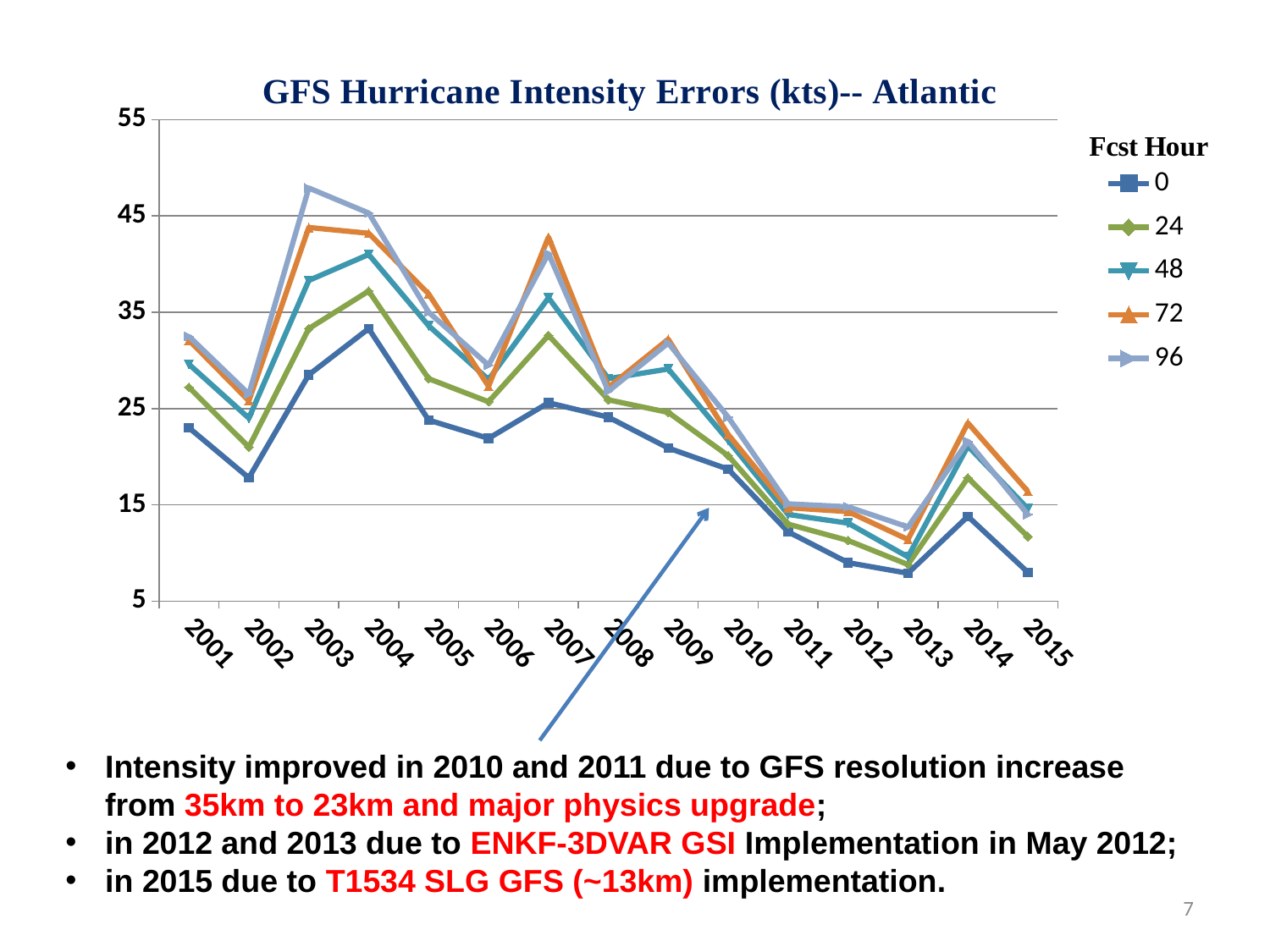
What is the title of the legend? Fcst Hour What is the title of the chart? GFS Hurricane Intensity Errors (kts)-- Atlantic How many years are plotted along the x axis? 15 Overall, do the intensity errors rise or fall from 2001 to 2015? fall Which forecast hour series has the highest value in 2003? 96 Is the value for the 0-hour series in 2011 greater or less than 15? less Is the value for the 72-hour series in 2007 greater or less than 35? greater What kind of chart is shown on the slide? line chart How many series does the legend list? 5 Is the value for the 96-hour series in 2003 greater or less than 45? greater In which year does the 96-hour series reach its highest value? 2003 In which year does the 0-hour series reach its highest value? 2004